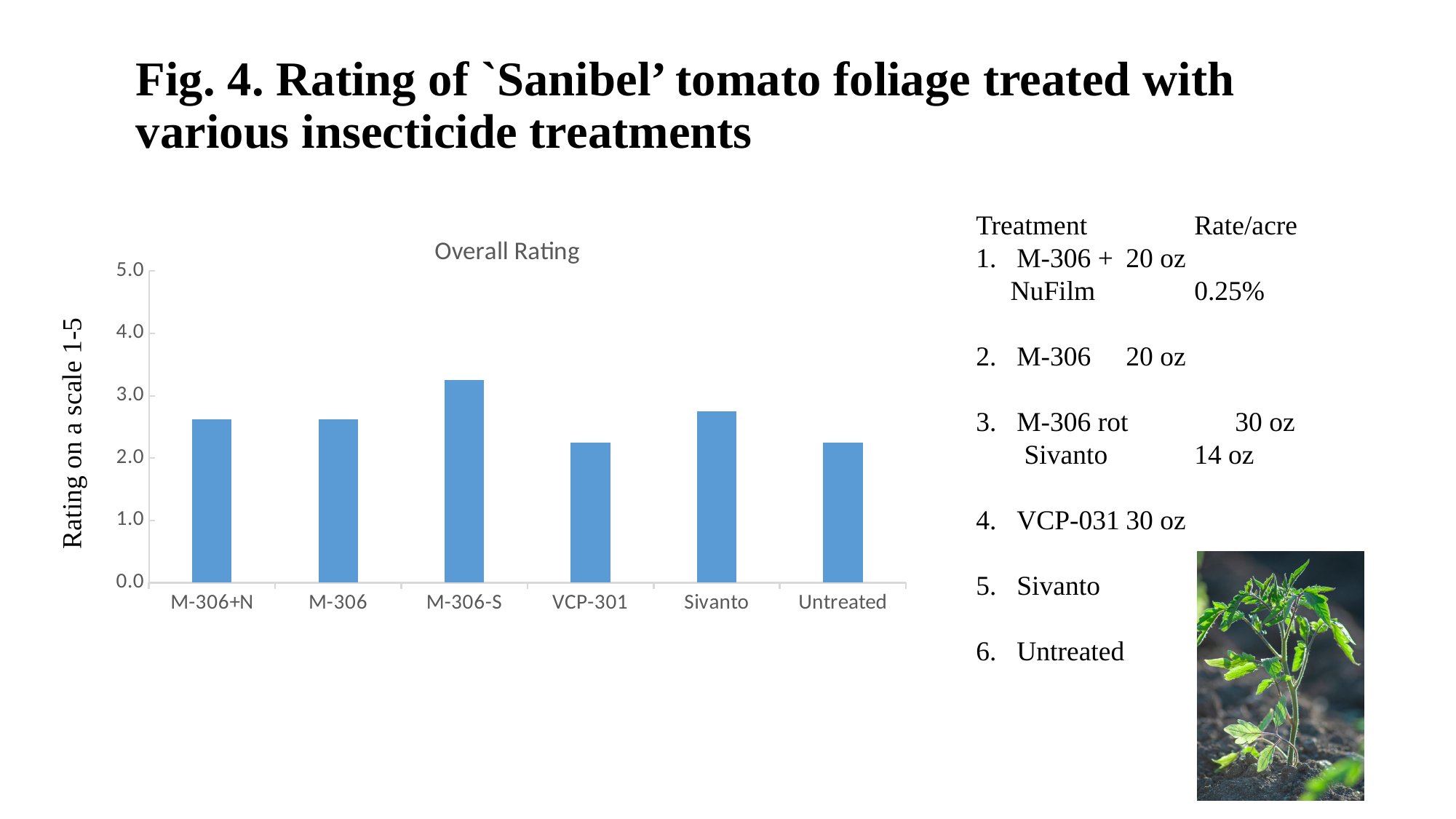
What is the label on the vertical axis of the chart? Rating on a scale 1-5 Which has a higher overall rating, M-306-S or Sivanto? M-306-S How many treatment categories are plotted in the chart? 6 What is the title of the chart? Overall Rating Which treatment has the highest overall rating in the chart? M-306-S Is the overall rating for Untreated greater or less than 3.0? less Is the overall rating for VCP-301 greater or less than 3.0? less Which has a higher overall rating, Sivanto or VCP-301? Sivanto Is the overall rating for M-306 greater or less than 2.0? greater What kind of chart is shown on the slide? bar chart